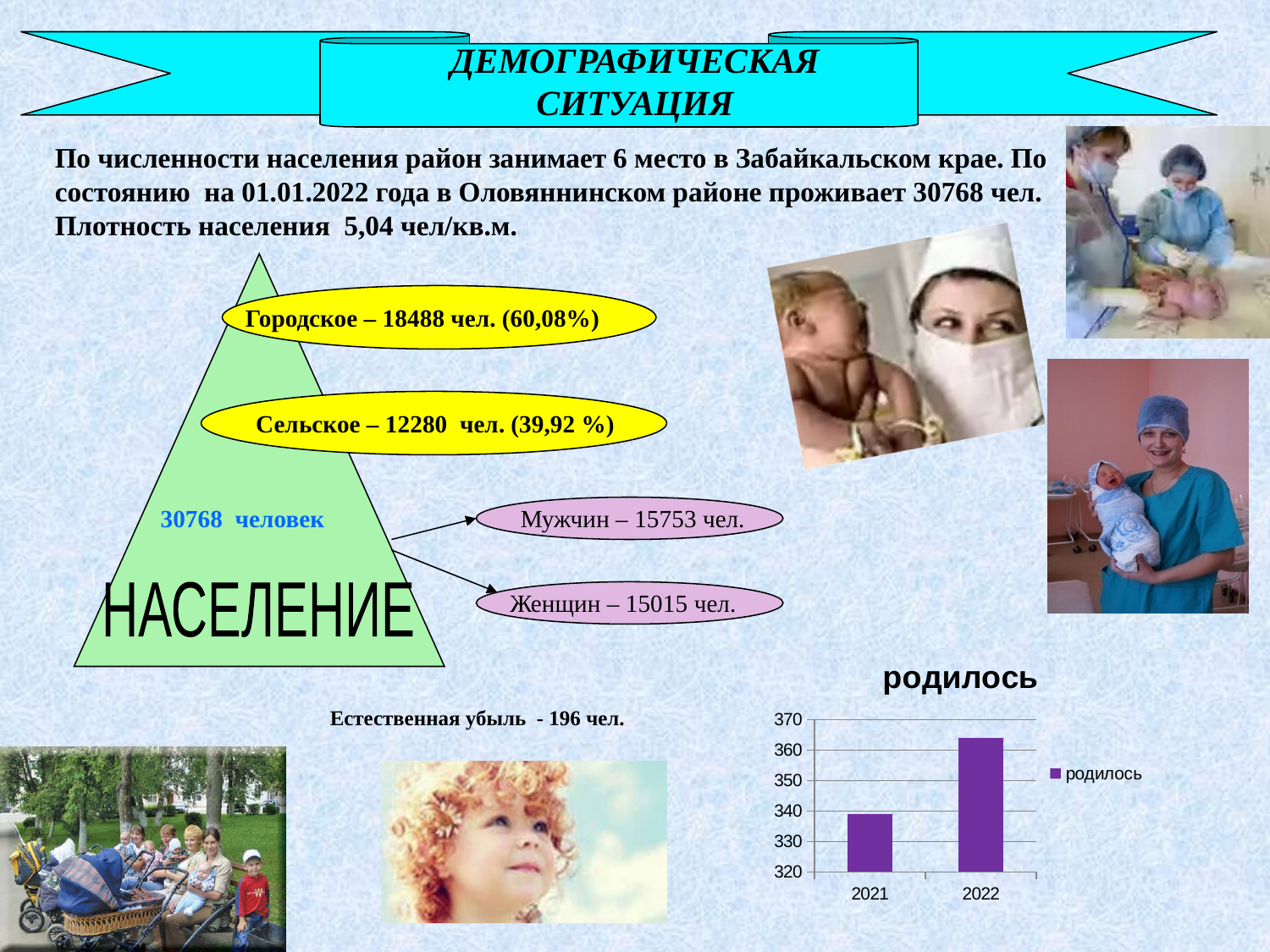
Which year has the lowest value in the chart? 2021 What is the name of the series listed in the chart's legend? родилось Do the values in the chart rise or fall from 2021 to 2022? rise Is the value for 2022 greater or less than 370? less What is the title of the chart? родилось How many series does the chart's legend list? 1 Which year has the highest value in the chart? 2022 Which is larger in the chart, the value for 2021 or the value for 2022? 2022 Is the value for 2021 greater or less than 330? greater How many categories are shown on the x axis of the chart? 2 Is the value for 2022 greater or less than 360? greater What kind of chart is shown on the slide? bar chart